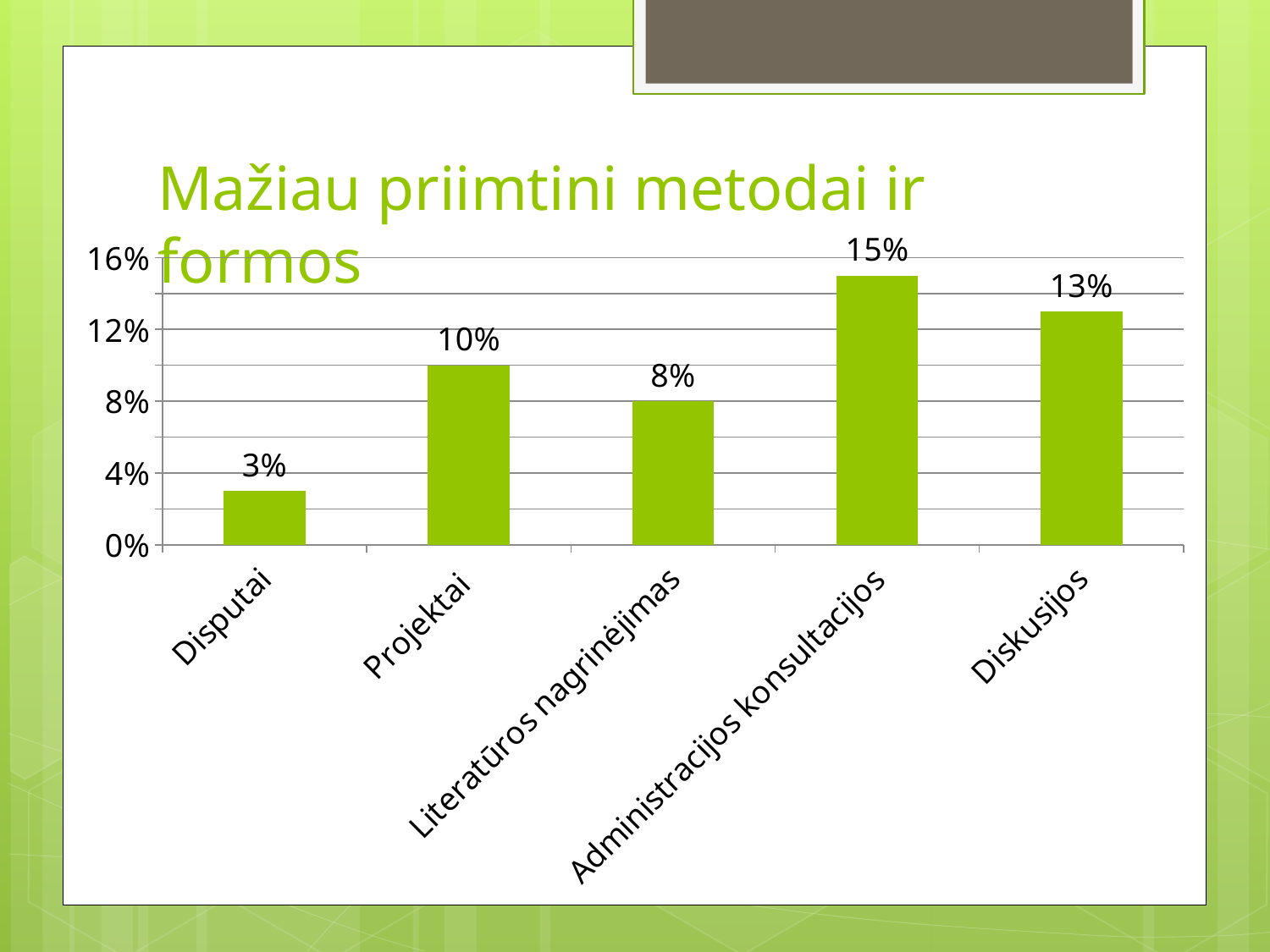
What is the value for Literatūros nagrinėjimas? 8% What kind of chart is shown on the slide? bar chart What is the value for Projektai? 10% What is the value for Diskusijos? 13% How many categories are shown on the chart? 5 What is the value for Administracijos konsultacijos? 15% What is the value for Disputai? 3% What is the difference between the values for Administracijos konsultacijos and Diskusijos? 2% Which category has the highest value? Administracijos konsultacijos Is the value for Diskusijos greater or less than 12%? greater Which category has the lowest value? Disputai Which is larger, the value for Projektai or the value for Literatūros nagrinėjimas? Projektai